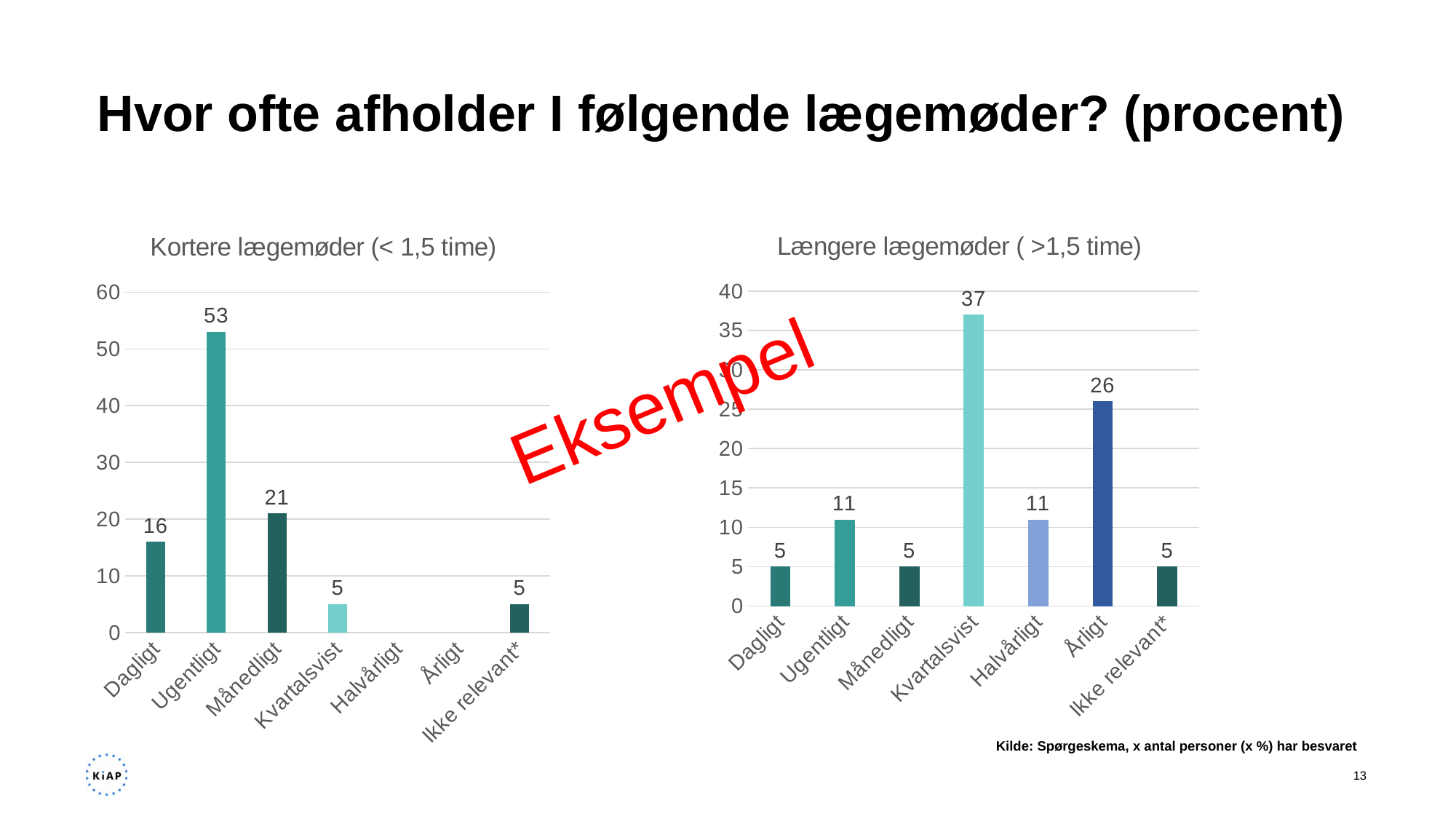
In the 'Kortere lægemøder (< 1,5 time)' chart, how many categories are shown on the x axis? 7 In the 'Længere lægemøder ( >1,5 time)' chart, which is larger, Ugentligt or Årligt? Årligt In the 'Længere lægemøder ( >1,5 time)' chart, which category has the highest value? Kvartalsvist In the 'Længere lægemøder ( >1,5 time)' chart, what is the difference between Kvartalsvist and Årligt? 11 In the 'Kortere lægemøder (< 1,5 time)' chart, what is the difference between Ugentligt and Dagligt? 37 In the 'Længere lægemøder ( >1,5 time)' chart, what is the value for Kvartalsvist? 37 What kind of chart is the 'Kortere lægemøder (< 1,5 time)' chart? Bar chart What is the title of the chart on the right side of the slide? Længere lægemøder ( >1,5 time) In the 'Længere lægemøder ( >1,5 time)' chart, what is the value for Årligt? 26 In the 'Kortere lægemøder (< 1,5 time)' chart, what is the value for Månedligt? 21 In the 'Kortere lægemøder (< 1,5 time)' chart, what is the value for Ugentligt? 53 In the 'Kortere lægemøder (< 1,5 time)' chart, which category has the highest value? Ugentligt